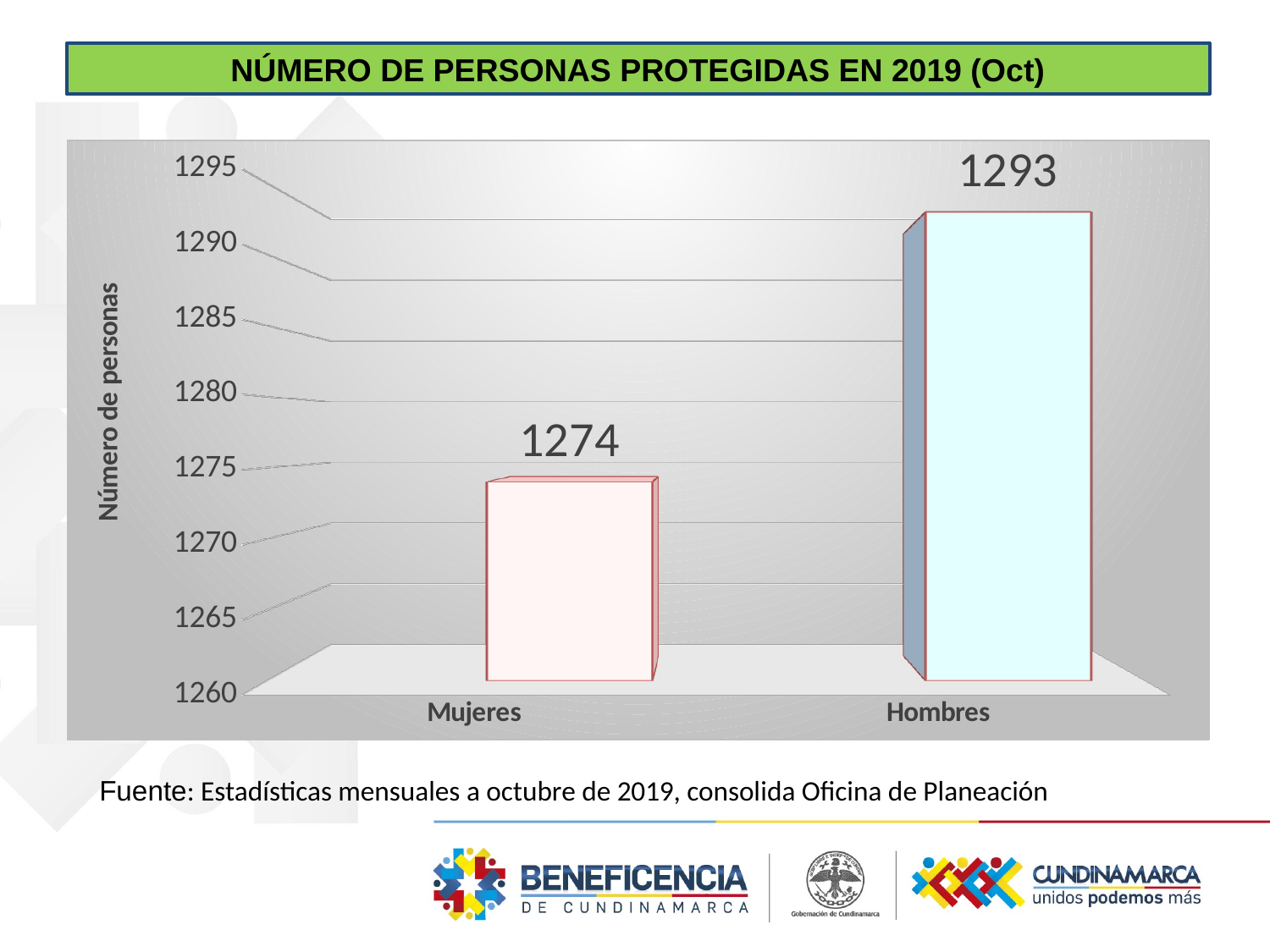
Is the value for Mujeres greater or less than 1280? less What kind of chart is shown on the slide? bar chart Which is larger, the value for Mujeres or the value for Hombres? Hombres What is the label of the vertical axis? Número de personas Which category has the lowest value? Mujeres How many categories are shown on the x axis? 2 What is the value for Hombres? 1293 Which category has the highest value? Hombres What is the value for Mujeres? 1274 What is the title of the chart? NÚMERO DE PERSONAS PROTEGIDAS EN 2019 (Oct) Is the value for Hombres greater or less than 1290? greater What is the difference between the values for Hombres and Mujeres? 19